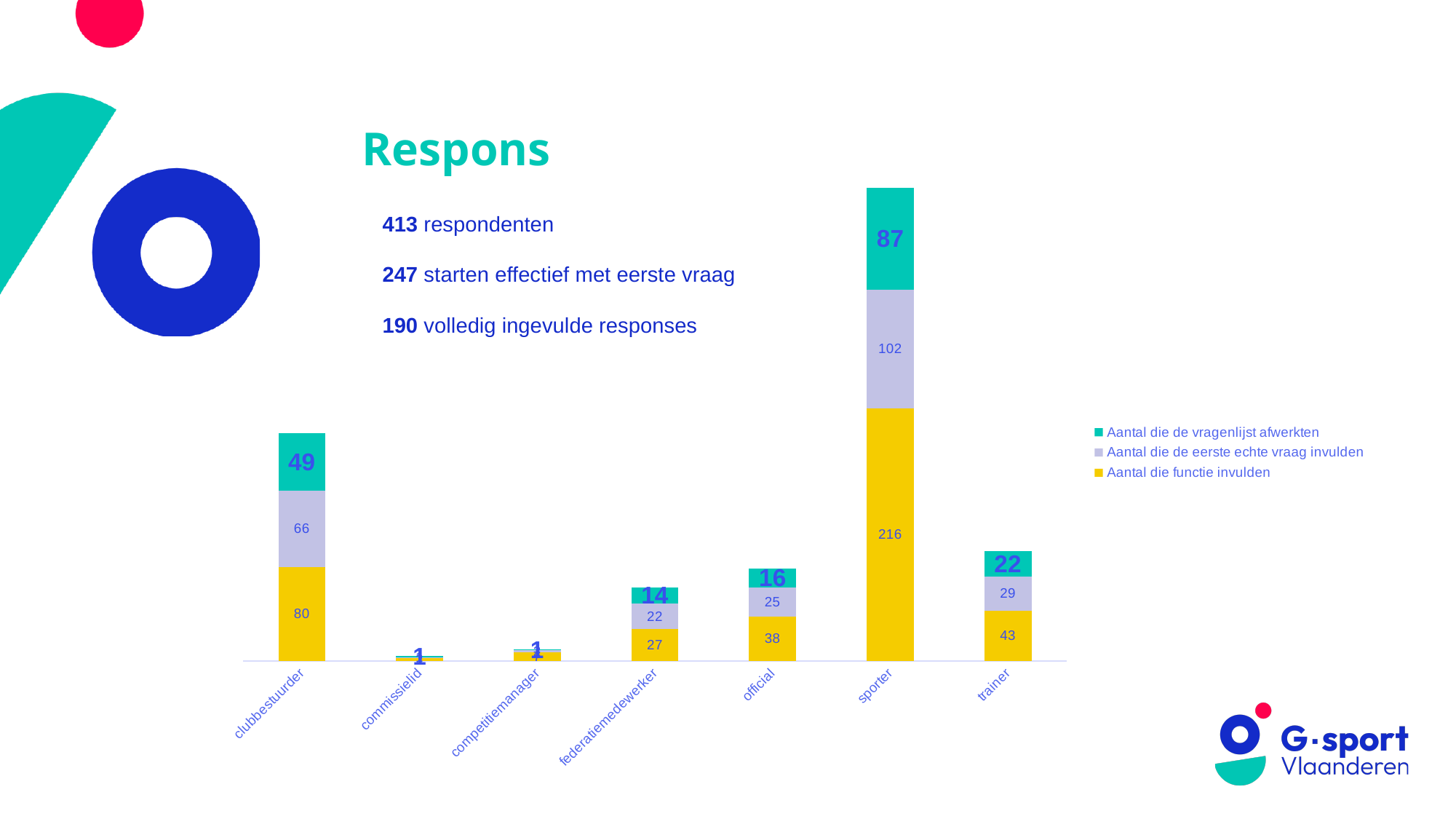
What is the value of 'Aantal die functie invulden' for sporter? 216 What kind of chart is shown on the slide? Stacked bar chart Which category has the highest total stacked bar? sporter How many series does the chart legend list? 3 What is the value of 'Aantal die de vragenlijst afwerkten' for clubbestuurder? 49 What is the value of 'Aantal die functie invulden' for official? 38 What is the total of the stacked bar for sporter? 405 What is the difference between 'Aantal die functie invulden' for sporter and for clubbestuurder? 136 How many categories are shown on the x axis of the chart? 7 What is the value of 'Aantal die de eerste echte vraag invulden' for trainer? 29 Which is larger: 'Aantal die de vragenlijst afwerkten' for trainer or for official? trainer What is the total of the stacked bar for clubbestuurder? 195